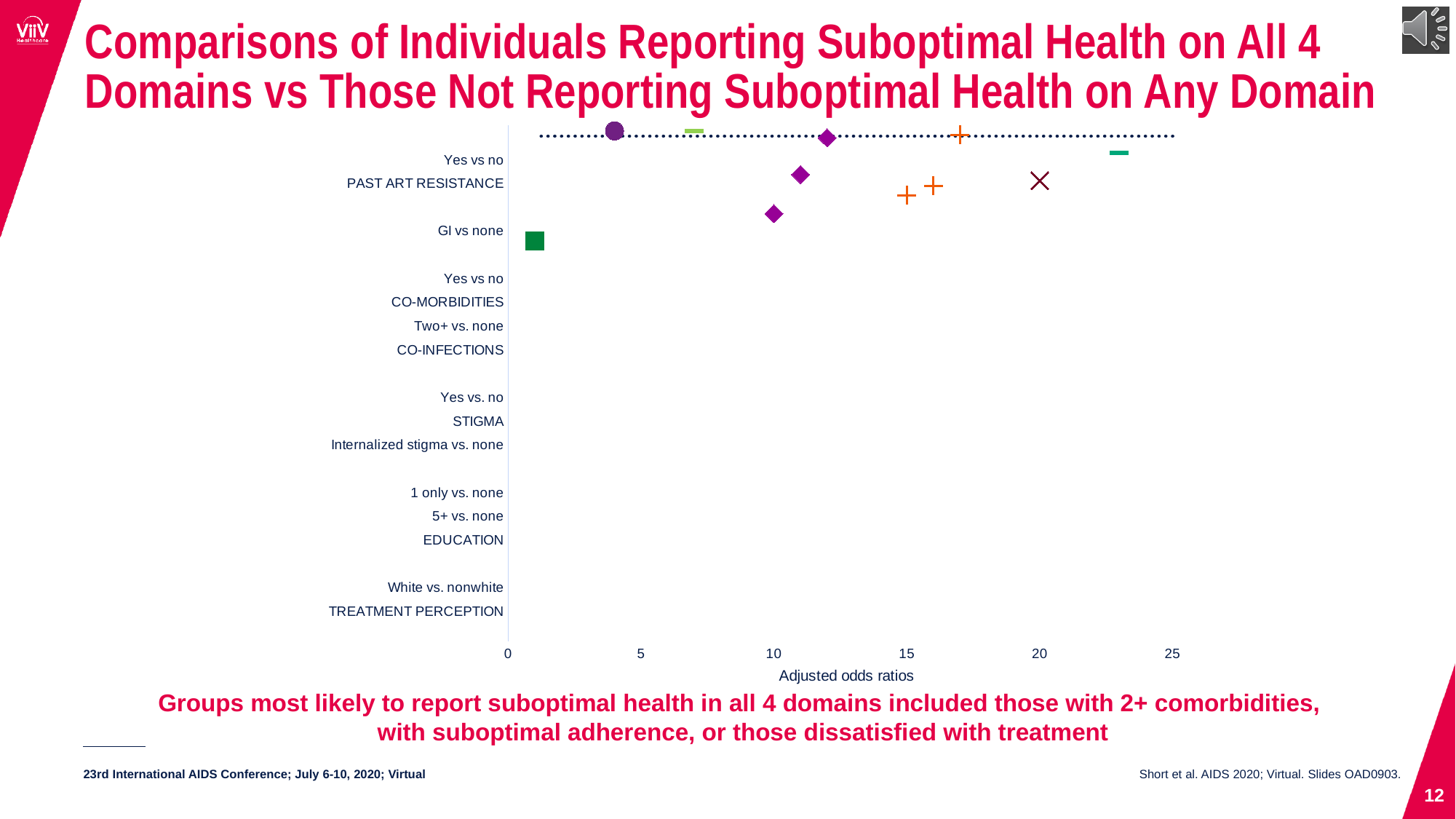
What kind of chart is shown on the slide? scatter chart Which marker is plotted furthest to the left on the chart? the green square Which marker is plotted furthest to the right on the chart? the teal dash Which marker has the larger adjusted odds ratio, the green square or the teal dash? the teal dash Is the adjusted odds ratio for the dark red X marker greater or less than 15? greater What is the title of the horizontal axis of the chart? Adjusted odds ratios How many tick labels are shown on the horizontal axis? 6 Is the adjusted odds ratio for the purple circle marker greater or less than 5? less Is the adjusted odds ratio for the teal dash marker greater or less than 20? greater What is the highest tick value shown on the horizontal axis? 25